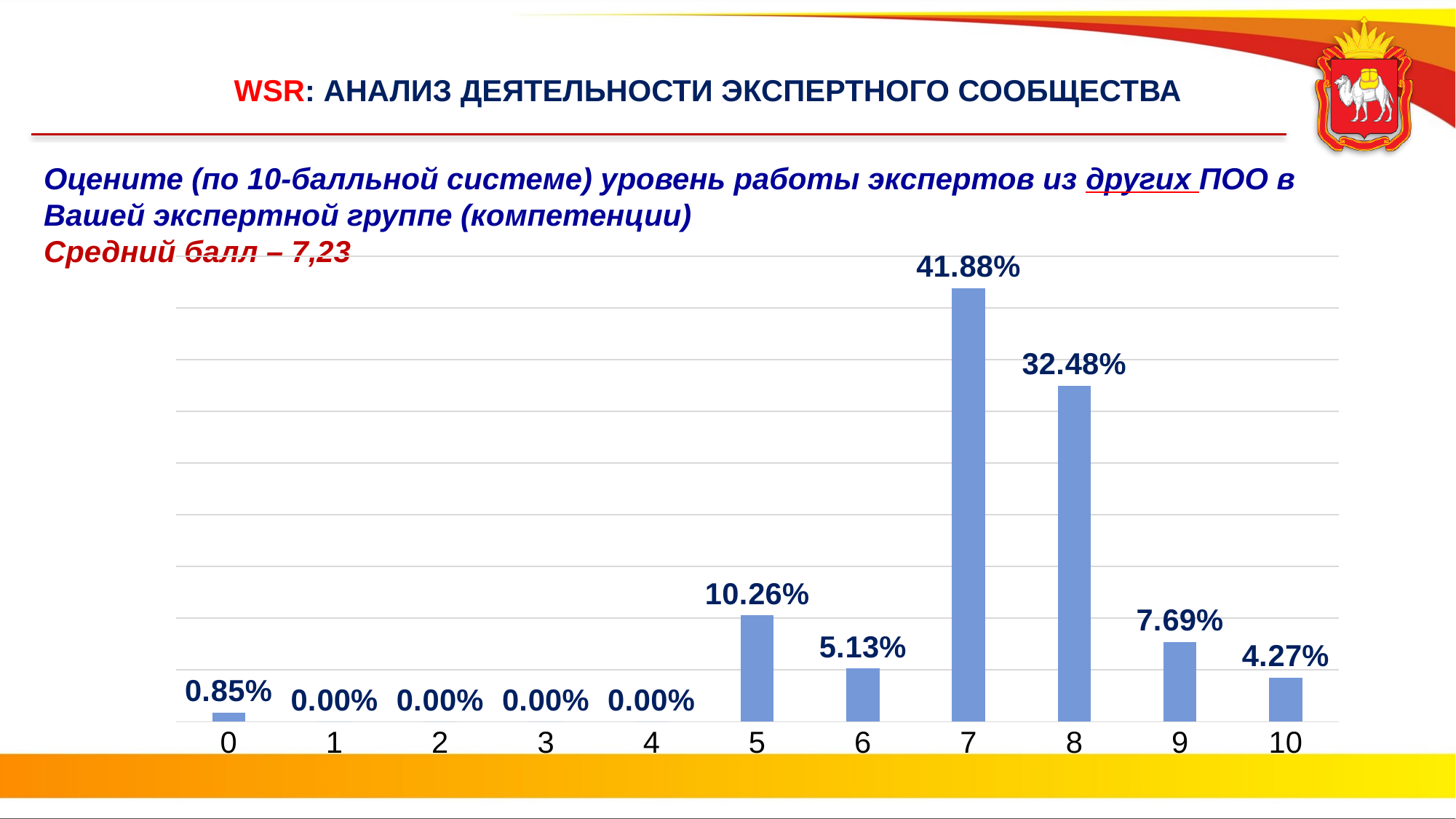
Which score has the highest percentage? 7 How many score categories have a value of 0.00%? 4 What is the difference between the percentages for score 5 and score 6? 5.13% What kind of chart is shown on the slide? bar chart What is the difference between the percentages for score 7 and score 8? 9.40% What percentage is shown for score 8? 32.48% What percentage is shown for score 10? 4.27% What percentage is shown for score 7? 41.88% What percentage is shown for score 0? 0.85% What percentage is shown for score 5? 10.26% Which is larger, the percentage for score 9 or for score 10? score 9 How many score categories are shown on the x axis? 11